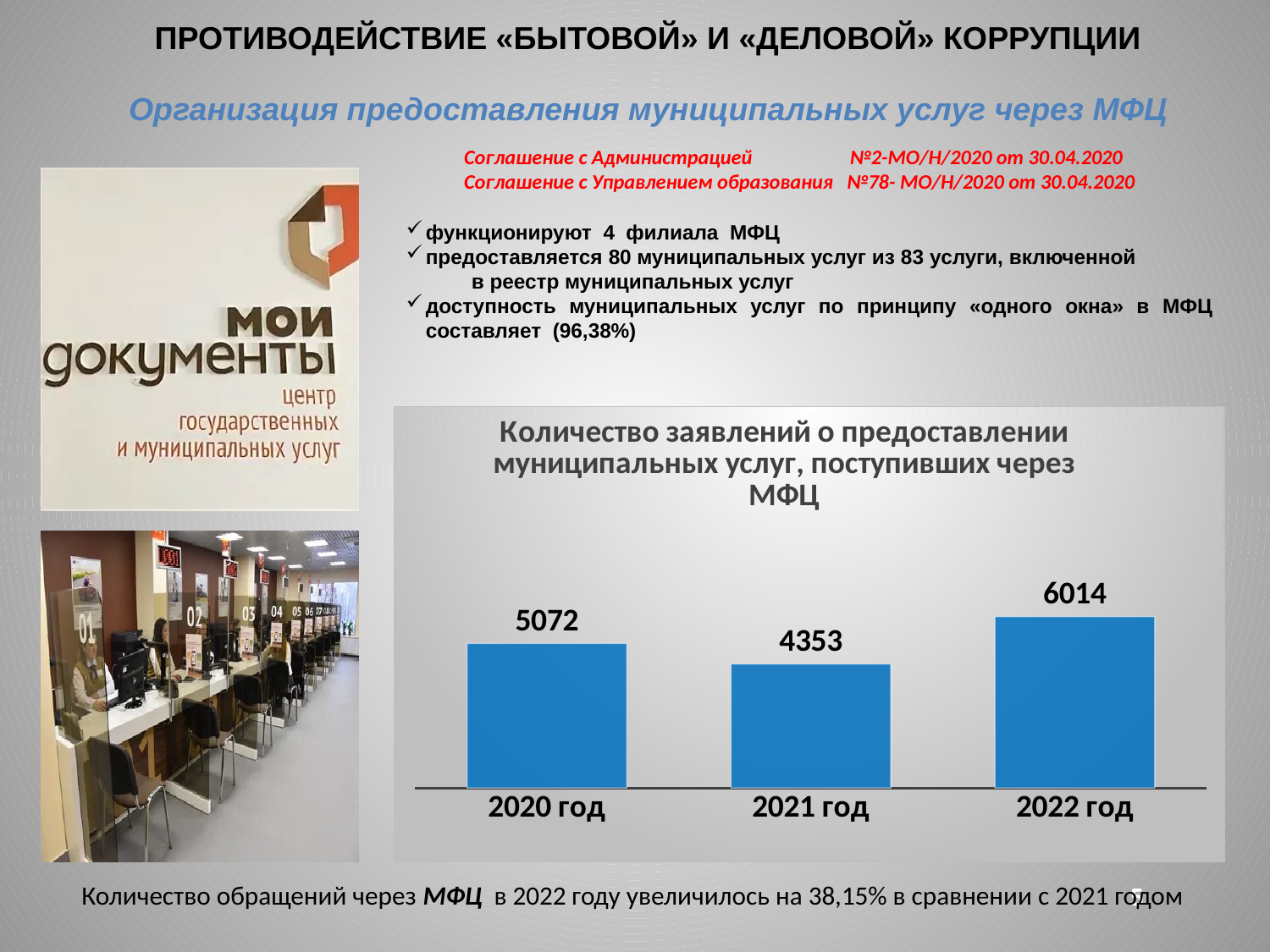
Which is larger, the value for 2020 год or the value for 2022 год? 2022 год What is the value for 2021 год? 4353 What is the difference between the values for 2022 год and 2021 год? 1661 What kind of chart is shown on the slide? bar chart Does the value rise or fall from 2021 год to 2022 год? rise How many categories are shown on the chart? 3 Which year has the highest number of applications? 2022 год What is the value for 2020 год? 5072 What is the difference between the values for 2020 год and 2021 год? 719 What is the value for 2022 год? 6014 Which year has the lowest number of applications? 2021 год What is the title of the chart? Количество заявлений о предоставлении муниципальных услуг, поступивших через МФЦ